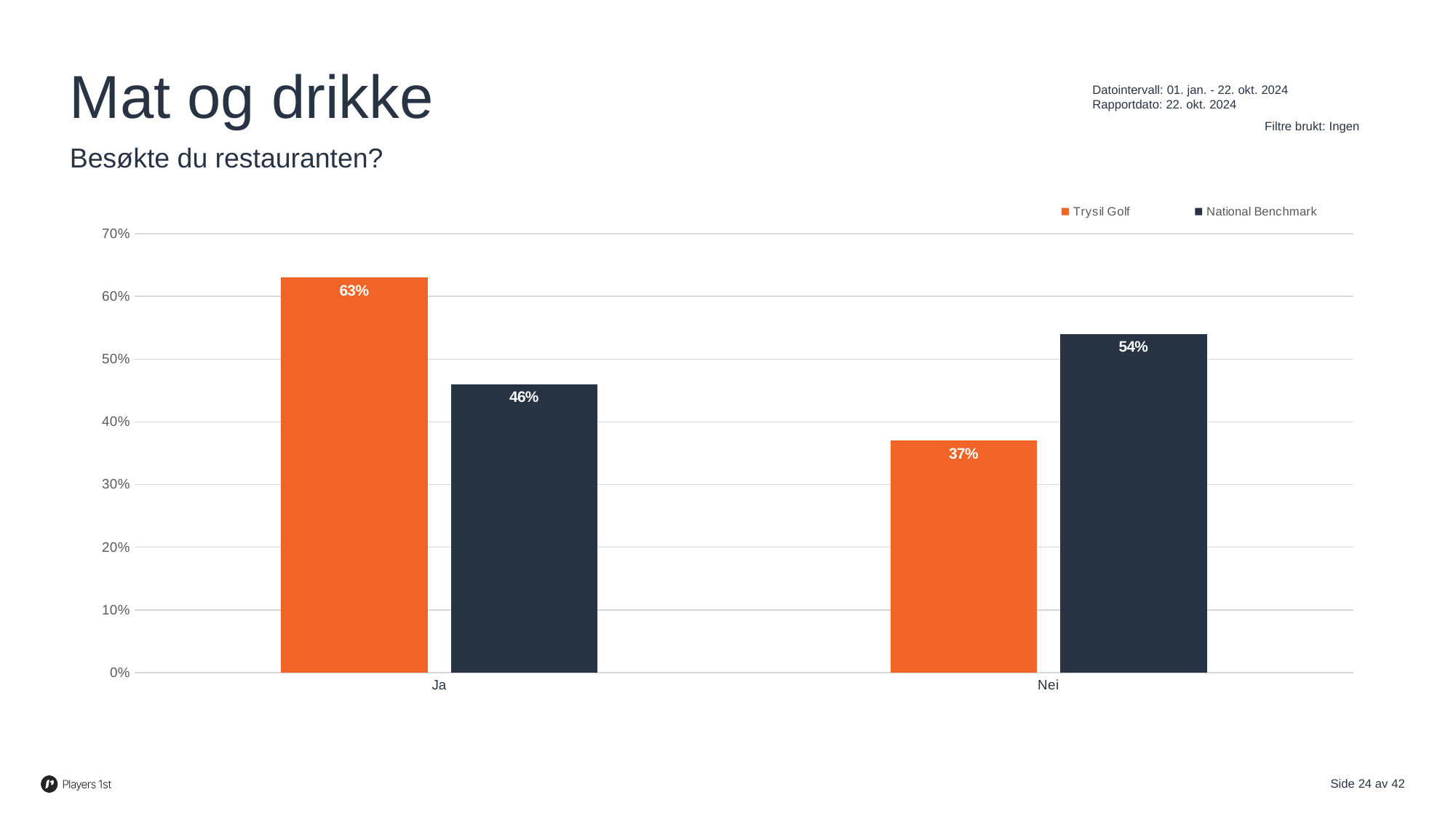
What is the difference between National Benchmark and Trysil Golf in the Nei category? 17 percentage points Which category has the highest value for Trysil Golf? Ja How many series does the legend list? 2 What is the value for National Benchmark in the Nei category? 54% Which category has the lowest value for National Benchmark? Ja What is the value for Trysil Golf in the Ja category? 63% What kind of chart is shown on the slide? Bar chart What is the difference between Trysil Golf and National Benchmark in the Ja category? 17 percentage points What is the value for Trysil Golf in the Nei category? 37% How many categories are shown on the x axis? 2 What is the value for National Benchmark in the Ja category? 46% Which is larger in the Nei category, Trysil Golf or National Benchmark? National Benchmark